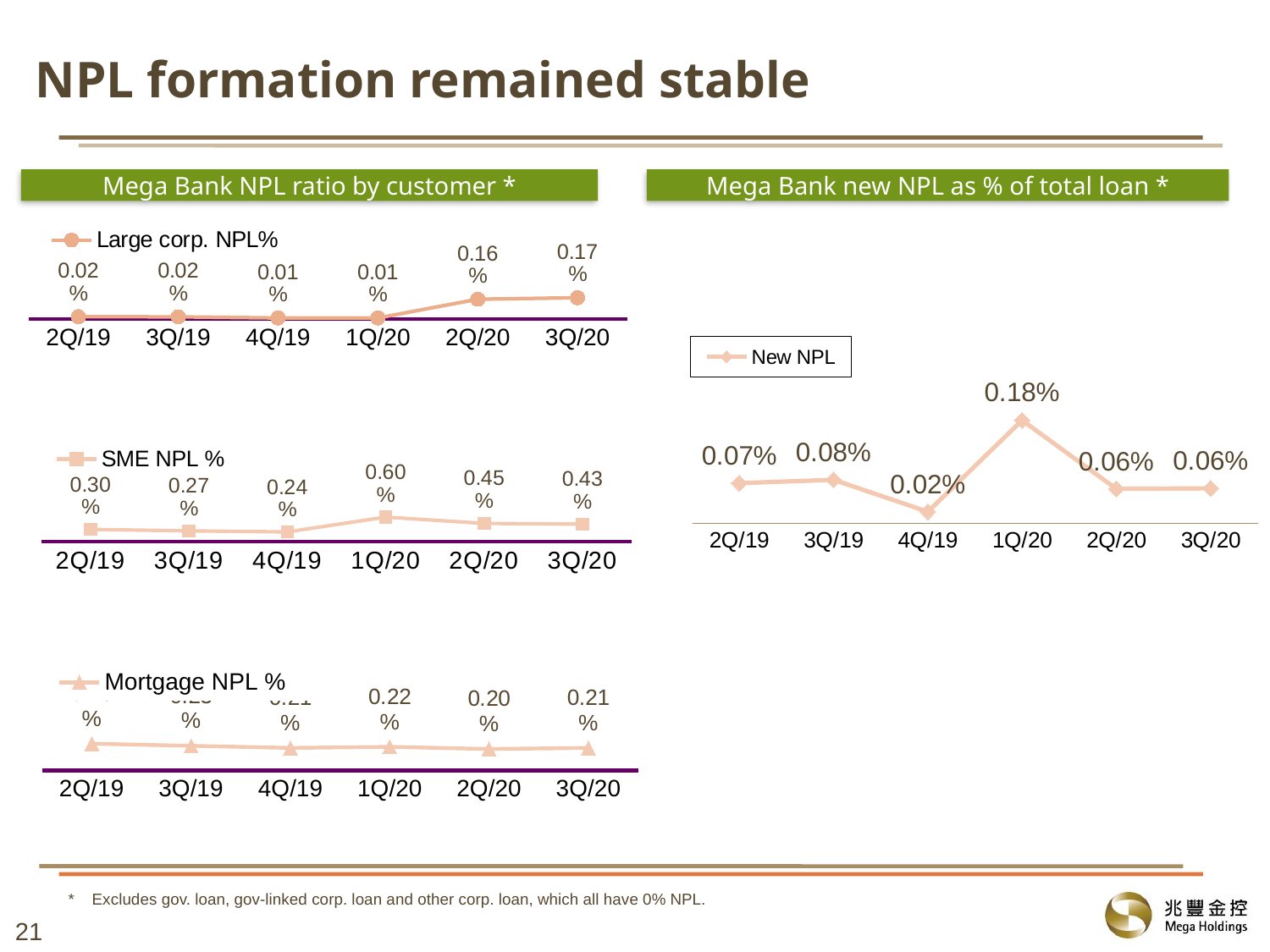
What type of chart is the Mega Bank new NPL as % of total loan chart? line chart In the Large corp. NPL% chart, what is the value for 3Q/20? 0.17% In the Mega Bank new NPL as % of total loan chart, which quarter has the lowest value? 4Q/19 In the Mortgage NPL % chart, what is the value for 2Q/20? 0.20% In the Mega Bank new NPL as % of total loan chart, how many quarters are plotted? 6 In the SME NPL % chart, which quarter has the highest value? 1Q/20 In the Large corp. NPL% chart, what is the value for 1Q/20? 0.01% In the Mega Bank new NPL as % of total loan chart, what is the value for 3Q/19? 0.08% In the Large corp. NPL% chart, is the value for 2Q/20 larger or smaller than the value for 4Q/19? larger In the SME NPL % chart, what is the value for 4Q/19? 0.24% In the Mega Bank new NPL as % of total loan chart, which quarter has the highest value? 1Q/20 In the SME NPL % chart, what is the difference between the 1Q/20 and 2Q/20 values? 0.15%